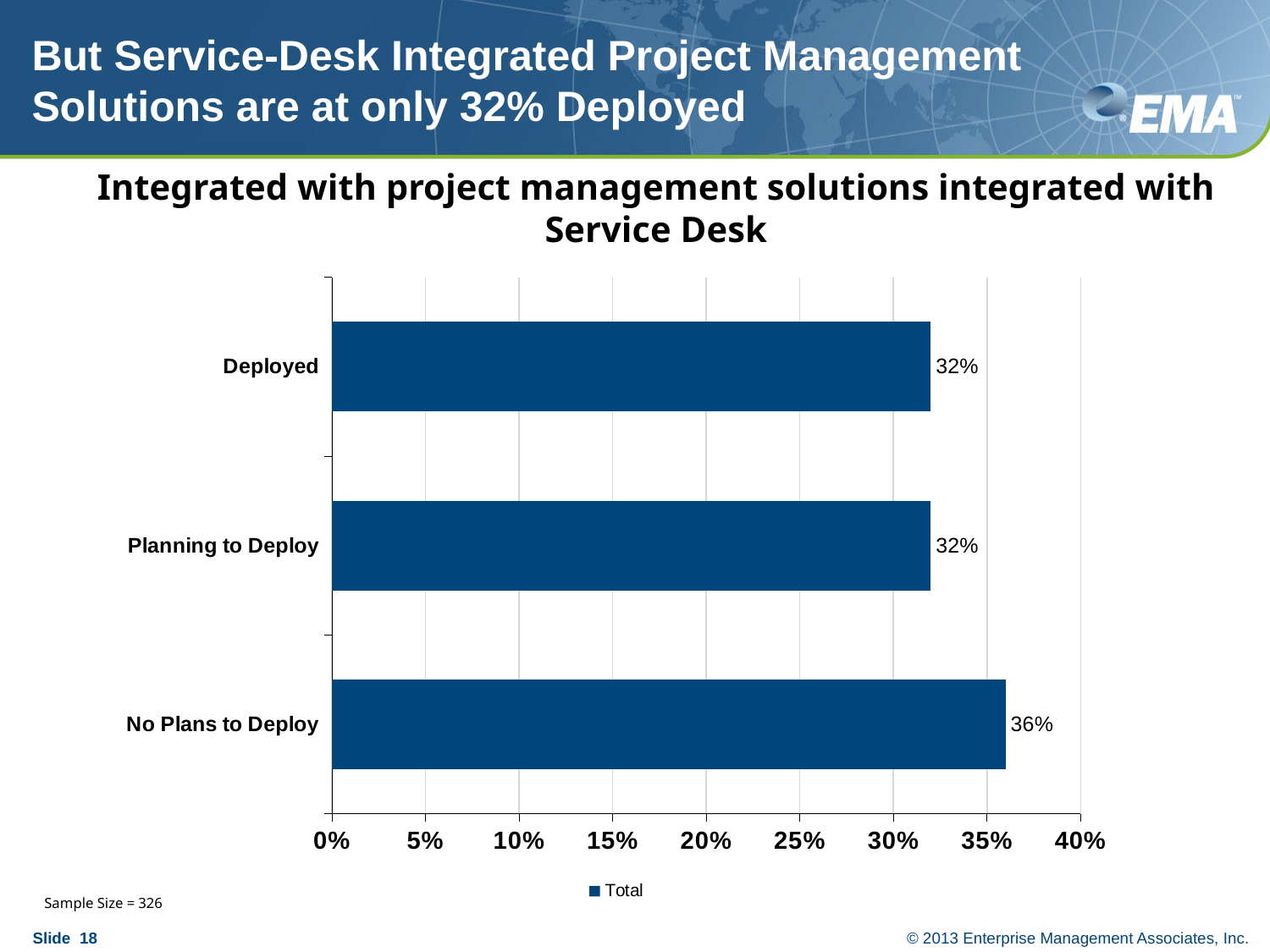
What is the name of the series listed in the legend? Total What is the value for Planning to Deploy? 32% How many series does the legend list? 1 How many categories are shown in the chart? 3 What is the difference between the values for No Plans to Deploy and Deployed? 4% Is the value for Deployed greater or less than 35%? less What kind of chart is shown? Bar chart Which is larger, the value for No Plans to Deploy or the value for Planning to Deploy? No Plans to Deploy Is the value for No Plans to Deploy greater or less than 35%? greater What is the value for No Plans to Deploy? 36% Which category has the highest value? No Plans to Deploy What is the value for Deployed? 32%